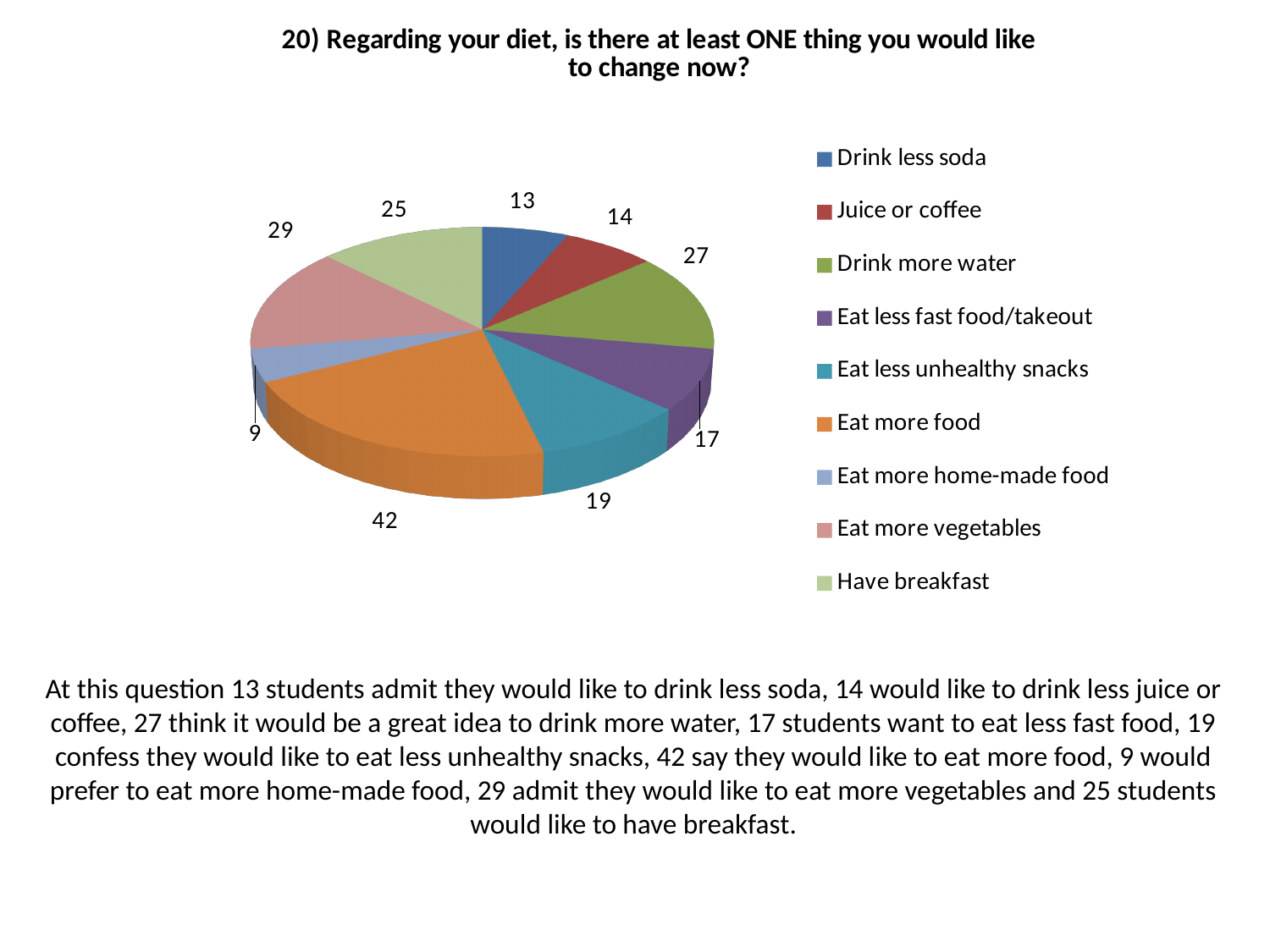
What value is shown for 'Eat more home-made food'? 9 What is the difference between the values for 'Eat more food' and 'Drink less soda'? 29 Which legend entry is shown in orange? Eat more food How many categories does the pie chart have? 9 What is the difference between the values for 'Eat more vegetables' and 'Have breakfast'? 4 How many students said they would like to eat more food? 42 What value is shown for 'Drink more water'? 27 What type of chart is shown on the slide? Pie chart Which category has the smallest slice of the pie? Eat more home-made food Which is larger: the value for 'Eat less unhealthy snacks' or the value for 'Eat less fast food/takeout'? Eat less unhealthy snacks Which category has the largest slice of the pie? Eat more food What is the total of all the values shown in the pie chart? 195